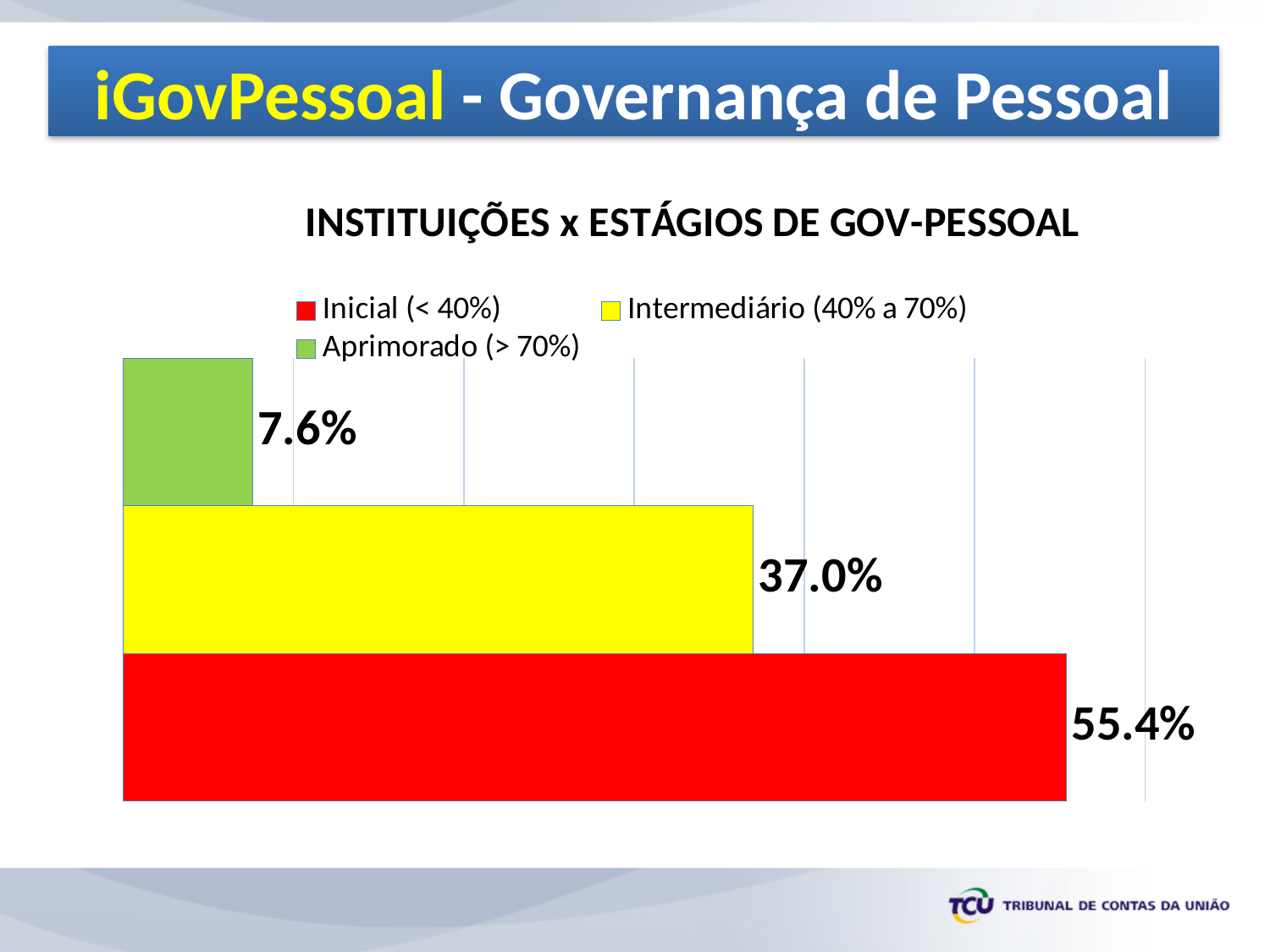
What percentage of institutions are in the Aprimorado (> 70%) stage? 7.6% What percentage of institutions are in the Intermediário (40% a 70%) stage? 37.0% What is the difference between the Inicial (< 40%) and Intermediário (40% a 70%) percentages? 18.4% Which stage has the lowest share of institutions? Aprimorado (> 70%) What is the difference between the Intermediário (40% a 70%) and Aprimorado (> 70%) percentages? 29.4% Which stage has the highest share of institutions? Inicial (< 40%) How many series does the legend list? 3 What kind of chart is shown on the slide? Bar chart What is the title of the chart? INSTITUIÇÕES x ESTÁGIOS DE GOV-PESSOAL Which is larger, the Intermediário (40% a 70%) share or the Aprimorado (> 70%) share? Intermediário (40% a 70%) What percentage of institutions are in the Inicial (< 40%) stage? 55.4% What colour is the bar for the Inicial (< 40%) stage? Red